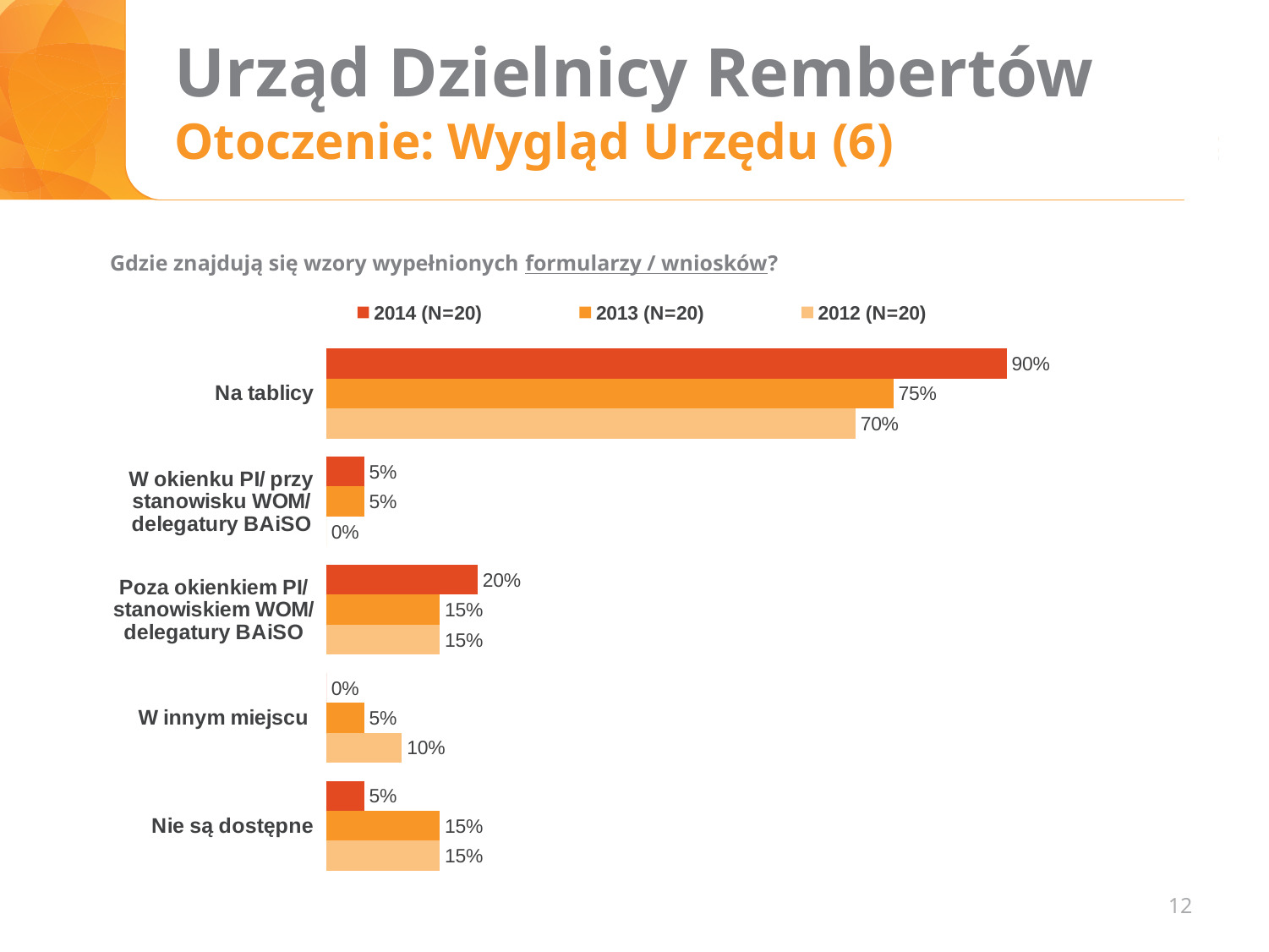
What is the value for "Na tablicy" in the 2014 (N=20) series? 90% What is the value for "Nie są dostępne" in the 2013 (N=20) series? 15% Which category has the lowest value in the 2012 (N=20) series? W okienku PI/ przy stanowisku WOM/ delegatury BAiSO Which category has the highest value in the 2014 (N=20) series? Na tablicy What is the value for "W innym miejscu" in the 2012 (N=20) series? 10% What is the difference between the 2014 (N=20) and 2012 (N=20) values for "Na tablicy"? 20% How many series does the legend list? 3 What question does the chart answer, as stated above it? Gdzie znajdują się wzory wypełnionych formularzy / wniosków? For "W innym miejscu", which series has the larger value: 2013 (N=20) or 2012 (N=20)? 2012 (N=20) What kind of chart is shown on the slide? Bar chart How many categories are shown on the chart? 5 What is the value for "Poza okienkiem PI/ stanowiskiem WOM/ delegatury BAiSO" in the 2014 (N=20) series? 20%